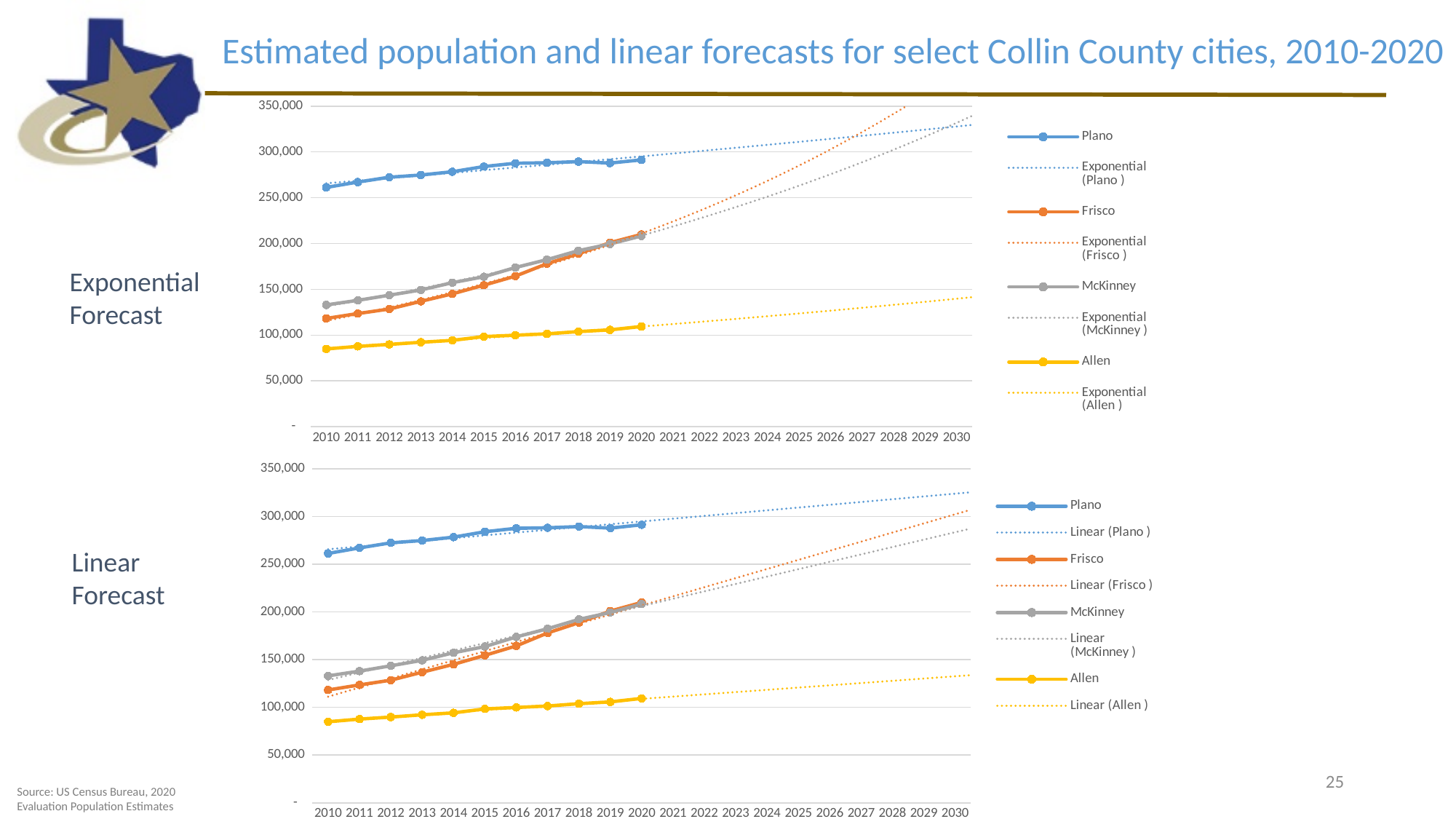
In the bottom Linear Forecast chart, is the value for Plano in 2010 greater or less than 250,000? greater In the top Exponential Forecast chart, is the value for Frisco in 2010 greater or less than 150,000? less How many series does the legend of the bottom Linear Forecast chart list? 8 In the top Exponential Forecast chart, which city has the highest estimated population in 2020? Plano In the bottom Linear Forecast chart, which is larger in 2010: McKinney or Frisco? McKinney How many years are labelled on the x axis of the bottom Linear Forecast chart? 21 What type of chart is the top Exponential Forecast chart? line chart In the top Exponential Forecast chart, which city has the lowest estimated population in 2010? Allen What colour is the Allen line in the bottom Linear Forecast chart? yellow How many series does the legend of the top Exponential Forecast chart list? 8 In the bottom Linear Forecast chart, is the value for Allen in 2020 greater or less than 150,000? less In the top Exponential Forecast chart, does the Frisco line rise or fall from 2010 to 2020? rise